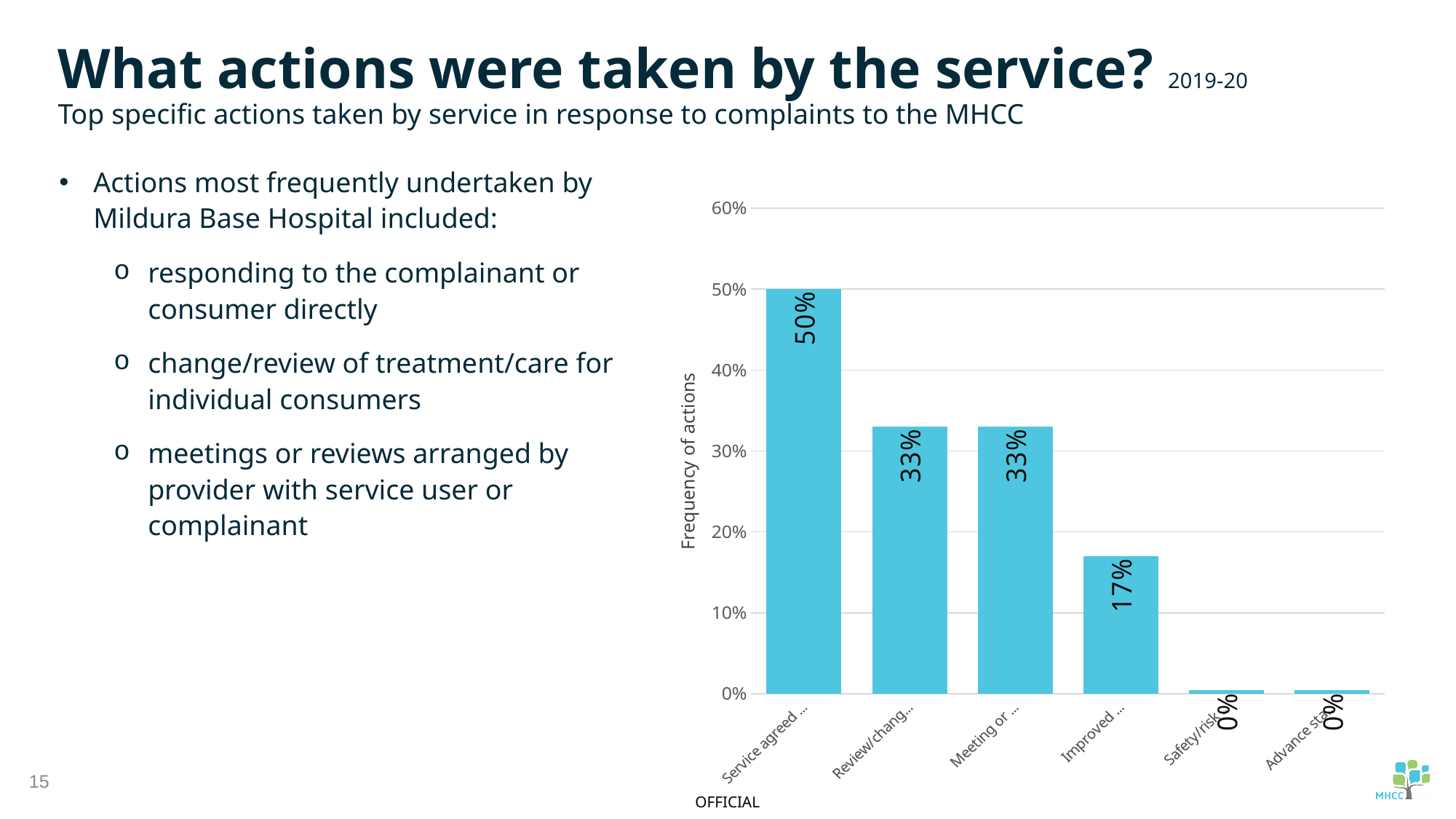
What is the value shown for the first bar, labelled "Service agreed ..."? 50% What kind of chart is shown on the slide? bar chart What is the value shown for the bar labelled "Improved ..."? 17% What is the label on the vertical axis of the chart? Frequency of actions What is the difference between the value for "Service agreed ..." and the value for "Improved ..."? 33 percentage points What is the value shown for the bar labelled "Safety/risk..."? 0% What is the value shown for the bar labelled "Review/chang..."? 33% How many categories (bars) are plotted in the chart? 6 Which is larger: the value for "Meeting or ..." or the value for "Improved ..."? Meeting or ... Which category has the highest value in the chart? Service agreed ... Is the value for "Improved ..." greater or less than 20%? less Do the bar values generally rise or fall from left to right along the x axis? fall